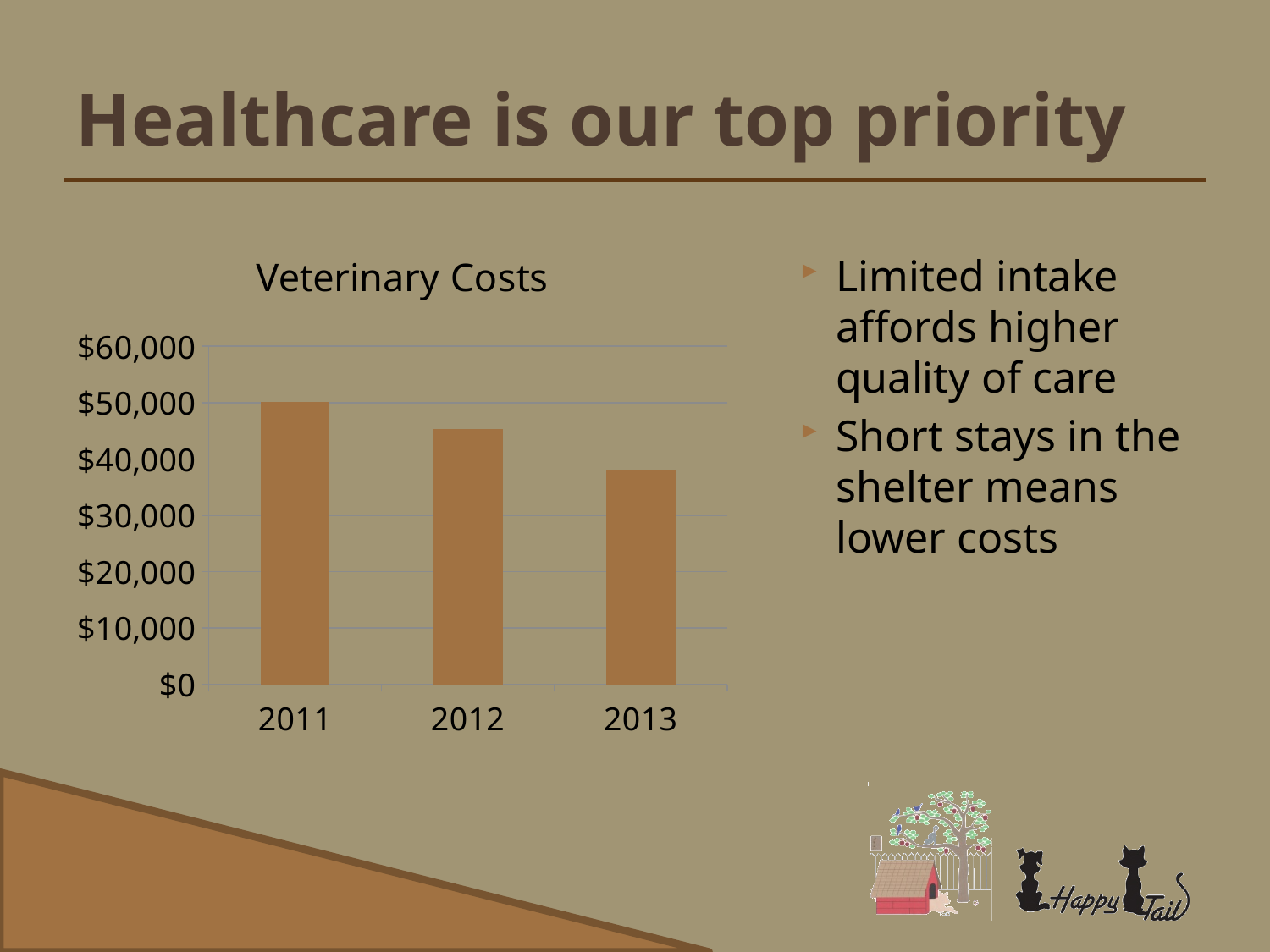
Which year has the highest veterinary costs? 2011 Is the value for 2012 greater or less than $40,000? greater What kind of chart is shown on the slide? bar chart Do veterinary costs rise or fall from 2011 to 2013? fall Is the value for 2013 greater or less than $30,000? greater Which year has the lowest veterinary costs? 2013 How many years are shown on the x axis of the Veterinary Costs chart? 3 Is the value for 2012 greater or less than $50,000? less What is the title of the chart? Veterinary Costs Which year has higher veterinary costs, 2011 or 2013? 2011